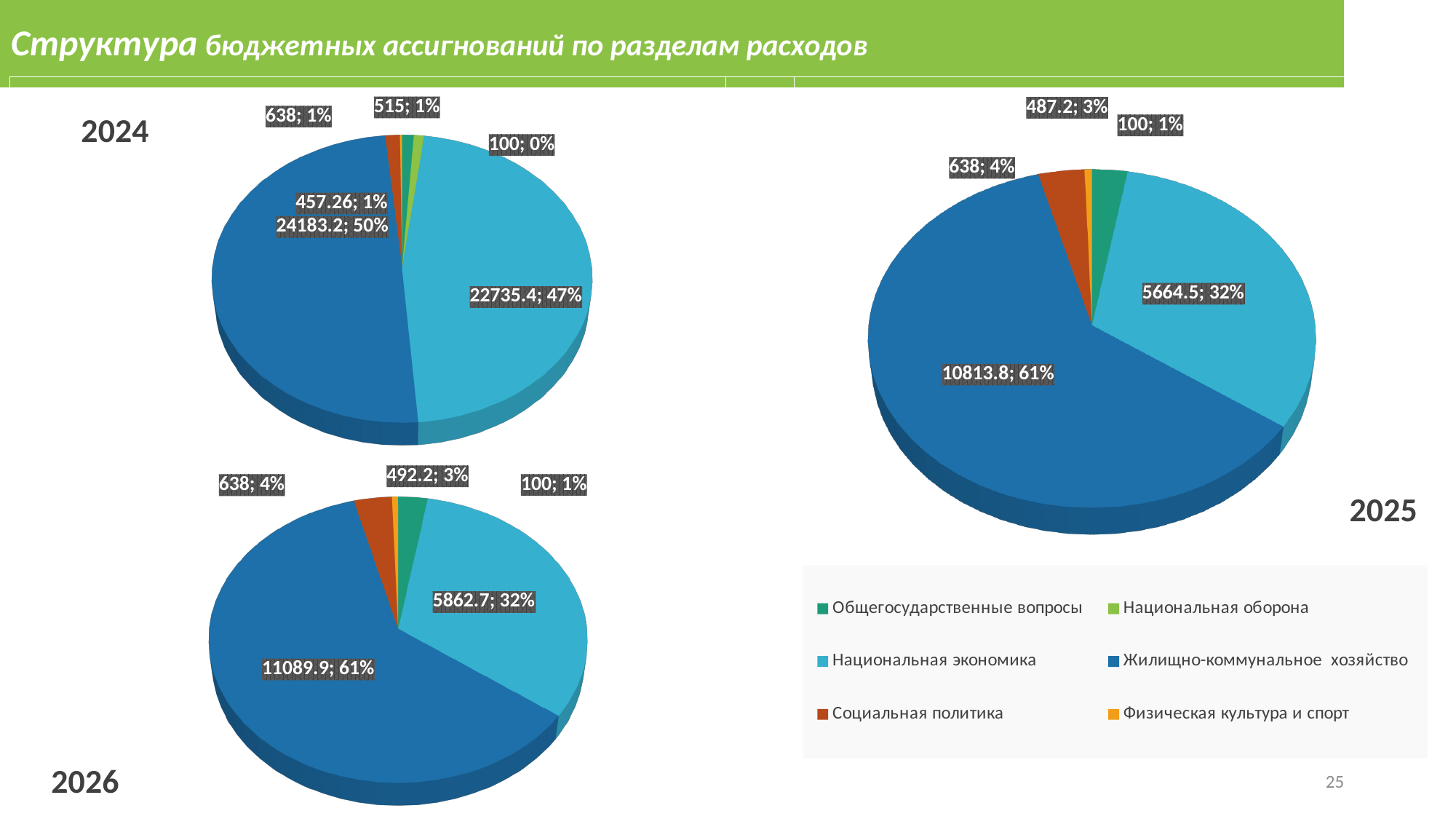
In the 2026 pie chart, what share of the pie does Социальная политика take? 4% How many categories does the legend list? 6 In the 2025 pie chart, what value and share are shown for Национальная экономика? 5664.5; 32% In the 2026 pie chart, what is the difference between the values for Жилищно-коммунальное хозяйство and Национальная экономика? 5227.2 What kind of charts are shown on the slide? Pie charts In the 2024 pie chart, what value and share are shown for Национальная экономика? 22735.4; 47% In the 2026 pie chart, what value and share are shown for Национальная экономика? 5862.7; 32% In the 2025 pie chart, what value and share are shown for Жилищно-коммунальное хозяйство? 10813.8; 61% In the 2024 pie chart, which is larger: Жилищно-коммунальное хозяйство or Национальная экономика? Жилищно-коммунальное хозяйство In the 2025 pie chart, which category has the largest slice? Жилищно-коммунальное хозяйство In the 2026 pie chart, what value and share are shown for Жилищно-коммунальное хозяйство? 11089.9; 61% In the 2024 pie chart, what value and share are shown for Жилищно-коммунальное хозяйство? 24183.2; 50%